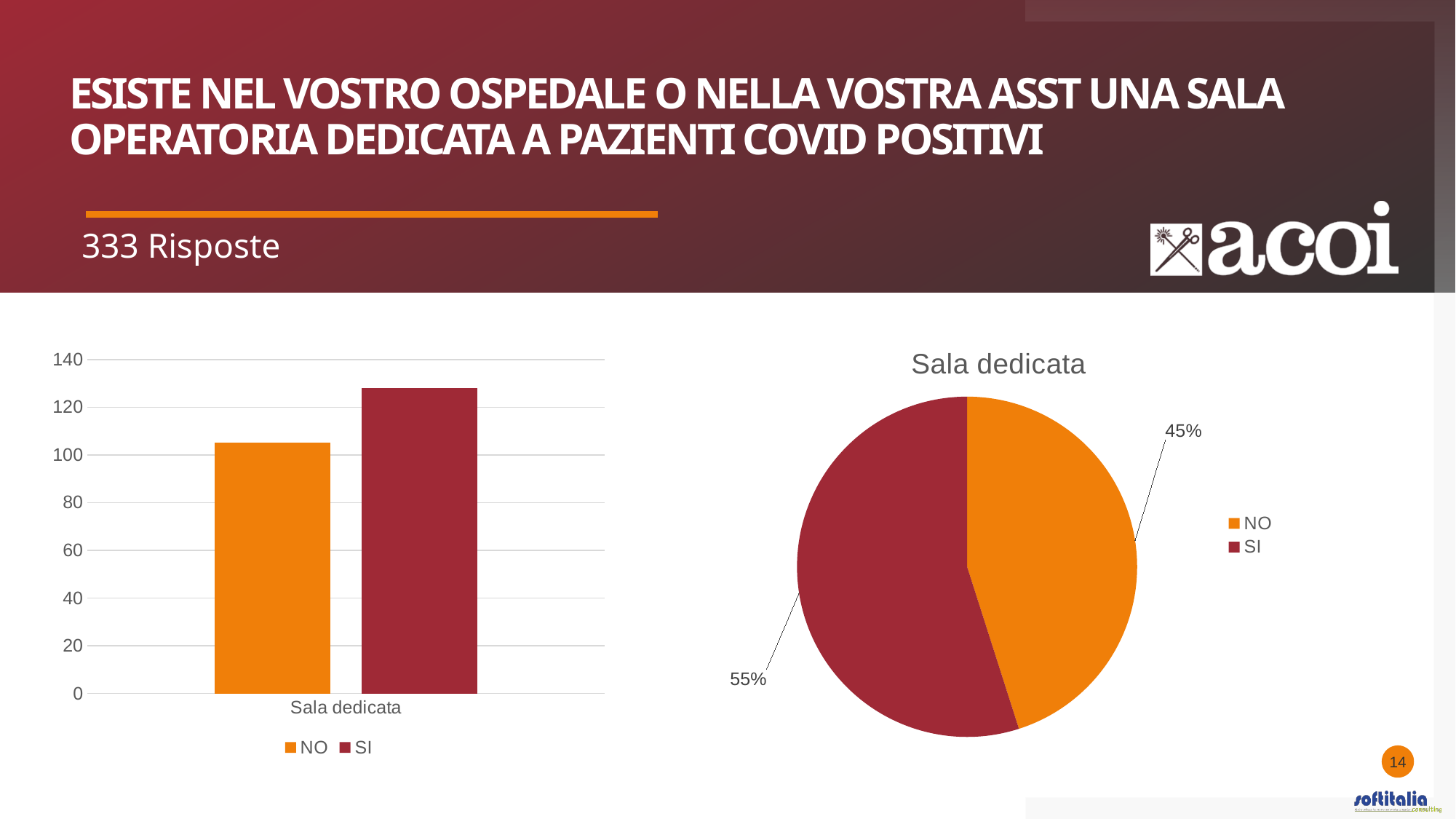
In the pie chart titled "Sala dedicata", which slice is the smallest? NO What kind of chart is the chart titled "Sala dedicata" on the right of the slide? pie chart How many series does the legend of the bar chart on the left list? 2 In the pie chart titled "Sala dedicata", what is the difference in percentage points between the SI and NO slices? 10 percentage points In the pie chart titled "Sala dedicata", which slice is the largest? SI What kind of chart is the chart on the left of the slide? bar chart In the bar chart on the left, is the value for SI greater or less than 120? greater In the pie chart titled "Sala dedicata", what share of the pie is the SI slice? 55% In the bar chart on the left, which series has the taller bar, NO or SI? SI In the bar chart on the left, what colour is the bar for NO? orange In the bar chart on the left, is the value for NO greater or less than 120? less In the pie chart titled "Sala dedicata", what share of the pie is the NO slice? 45%